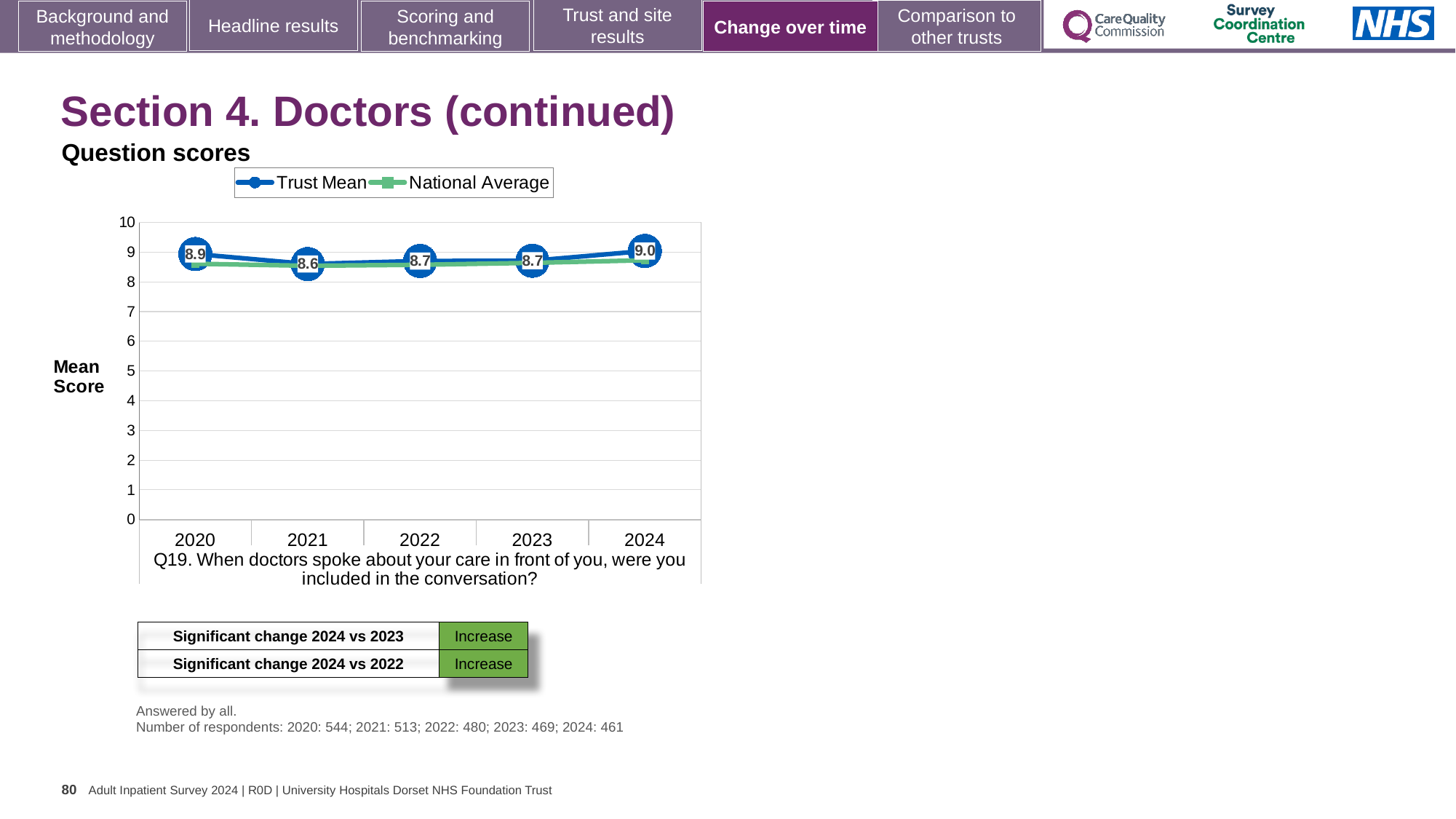
In which year is the Trust Mean score highest? 2024 What is the difference between the Trust Mean score in 2024 and in 2021? 0.4 Is the National Average value for 2020 greater or less than 8? greater What is the Trust Mean score for 2021? 8.6 What is the Trust Mean score for 2020? 8.9 What kind of chart is shown on the slide? Line chart In which year is the Trust Mean score lowest? 2021 How many years are shown on the x axis of the chart? 5 What are the two series named in the chart legend? Trust Mean and National Average What is the Trust Mean score for 2024? 9.0 Which year has the larger Trust Mean score, 2020 or 2021? 2020 How many series does the chart legend list? 2